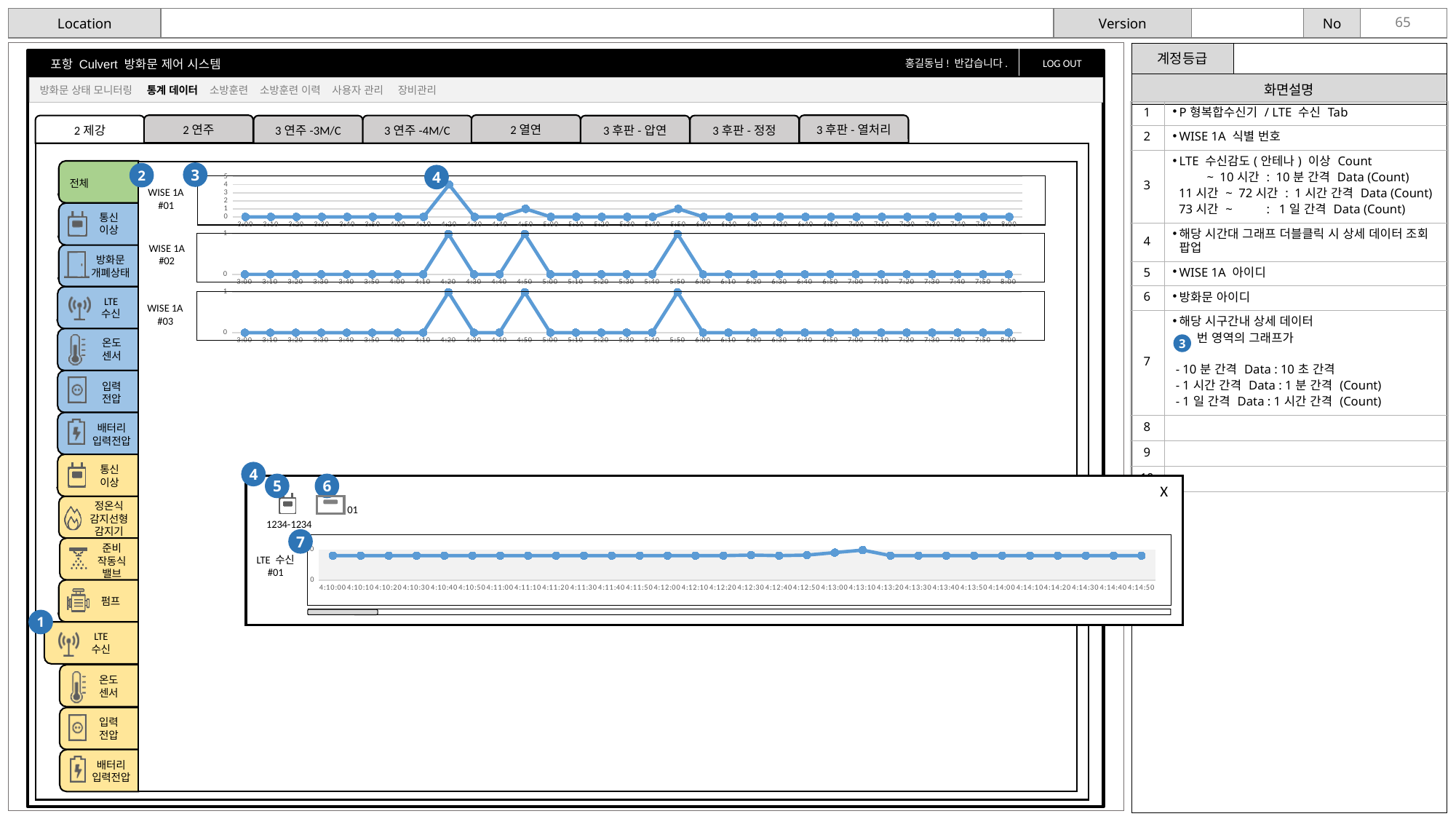
In the WISE 1A #03 chart, what is the value at 5:50? 1 In the WISE 1A #01 chart, at which time is the value highest? 4:20 How many WISE 1A charts are shown in the main panel? 3 In the WISE 1A #01 chart, which is larger, the value at 4:20 or the value at 4:50? 4:20 In the WISE 1A #02 chart, what is the value at 4:20? 1 What is the label of the chart in the popup window at the bottom of the slide? LTE 수신 #01 In the WISE 1A #02 chart, what is the value at 3:00? 0 In the WISE 1A #01 chart, is the value at 4:20 greater or less than 3? greater What is the first time label on the x axis of the WISE 1A #02 chart? 3:00 What kind of chart is the WISE 1A #01 chart? line chart In the WISE 1A #03 chart, what is the value at 7:00? 0 In the popup chart LTE 수신 #01, is the value at 4:13:10 greater or less than 0? greater